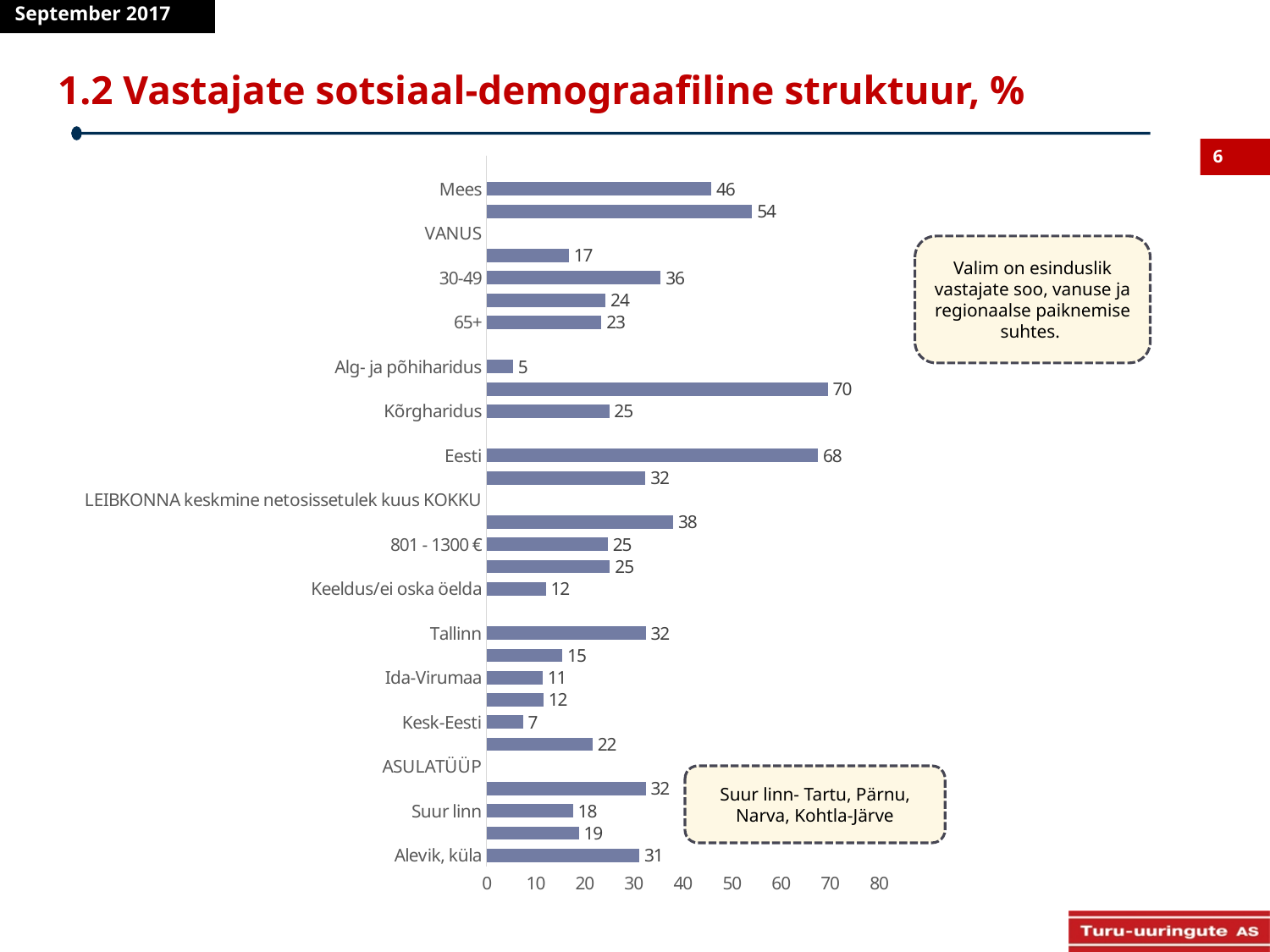
What is the title of the slide containing the chart? 1.2 Vastajate sotsiaal-demograafiline struktuur, % What is the difference between the values for Tallinn and Ida-Virumaa? 21 What is the value for Alevik, küla? 31 What type of chart is shown on the slide? bar chart Which labelled category has the lowest value in the chart? Alg- ja põhiharidus What is the value for Eesti? 68 What is the value for the 30-49 age group? 36 What is the value for Kõrgharidus? 25 What is the value for 65+? 23 What is the value for Mees? 46 Is the value for Eesti greater or less than 60? greater Which is larger, the value for Suur linn or the value for Alevik, küla? Alevik, küla